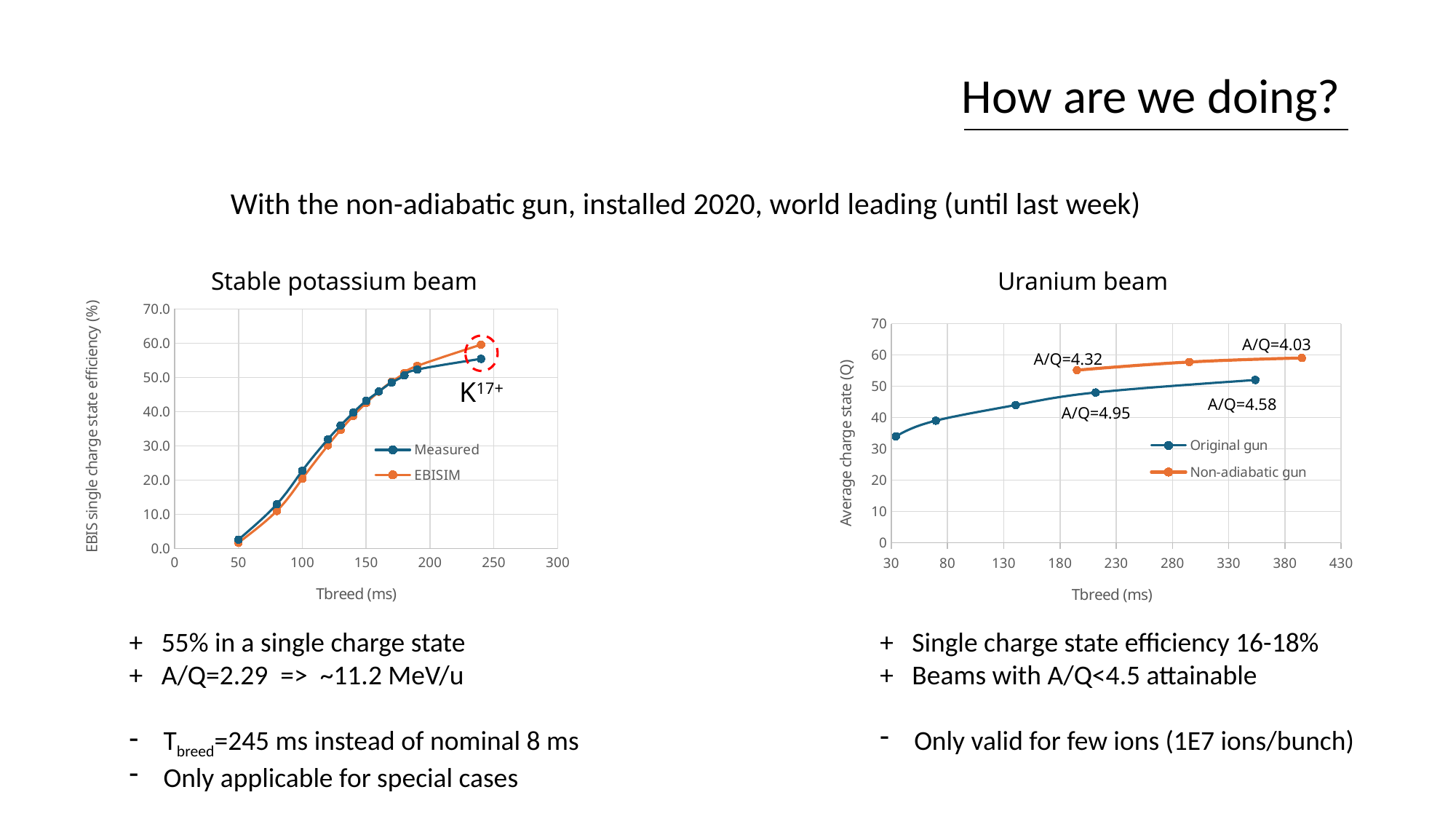
How many series does the legend of the "Uranium beam" chart list? 2 What kind of chart is the "Stable potassium beam" chart? Line chart In the "Stable potassium beam" chart, which series are listed in the legend? Measured and EBISIM In the "Stable potassium beam" chart, at 240 ms, which series has the higher value, Measured or EBISIM? EBISIM In the "Stable potassium beam" chart, is the Measured value at 50 ms greater or less than 10.0? less In the "Uranium beam" chart, which series reaches the higher average charge state, Original gun or Non-adiabatic gun? Non-adiabatic gun In the "Stable potassium beam" chart, is the Measured value at 240 ms greater or less than 50.0? greater In the "Stable potassium beam" chart, which ion is labelled next to the circled point? K17+ In the "Uranium beam" chart, is the last Non-adiabatic gun value (near 400 ms) greater or less than 50? greater In the "Uranium beam" chart, how many data points does the Non-adiabatic gun series have? 3 How many series does the legend of the "Stable potassium beam" chart list? 2 In the "Stable potassium beam" chart, do the Measured values rise or fall as Tbreed increases? Rise